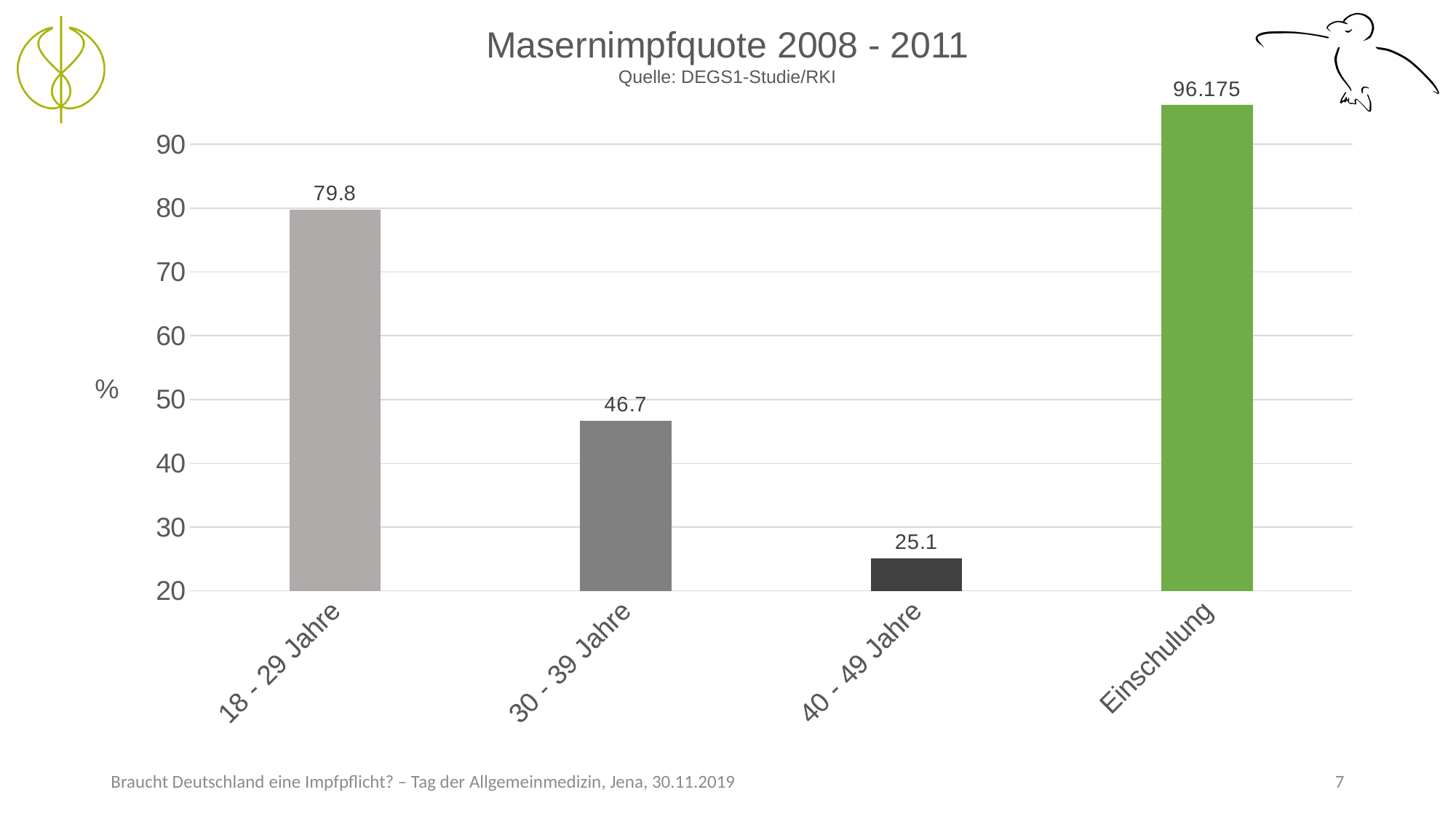
What is the value for 18 - 29 Jahre? 79.8 Which category has the highest value? Einschulung How many categories are shown on the x axis? 4 What is the value for 40 - 49 Jahre? 25.1 Which category has the lowest value? 40 - 49 Jahre Which is larger, the value for 30 - 39 Jahre or the value for 40 - 49 Jahre? 30 - 39 Jahre What is the title of the chart? Masernimpfquote 2008 - 2011 What is the value for Einschulung? 96.175 What kind of chart is shown on the slide? bar chart Is the value for 18 - 29 Jahre greater or less than 70? greater What is the difference between the values for 18 - 29 Jahre and 30 - 39 Jahre? 33.1 What is the value for 30 - 39 Jahre? 46.7